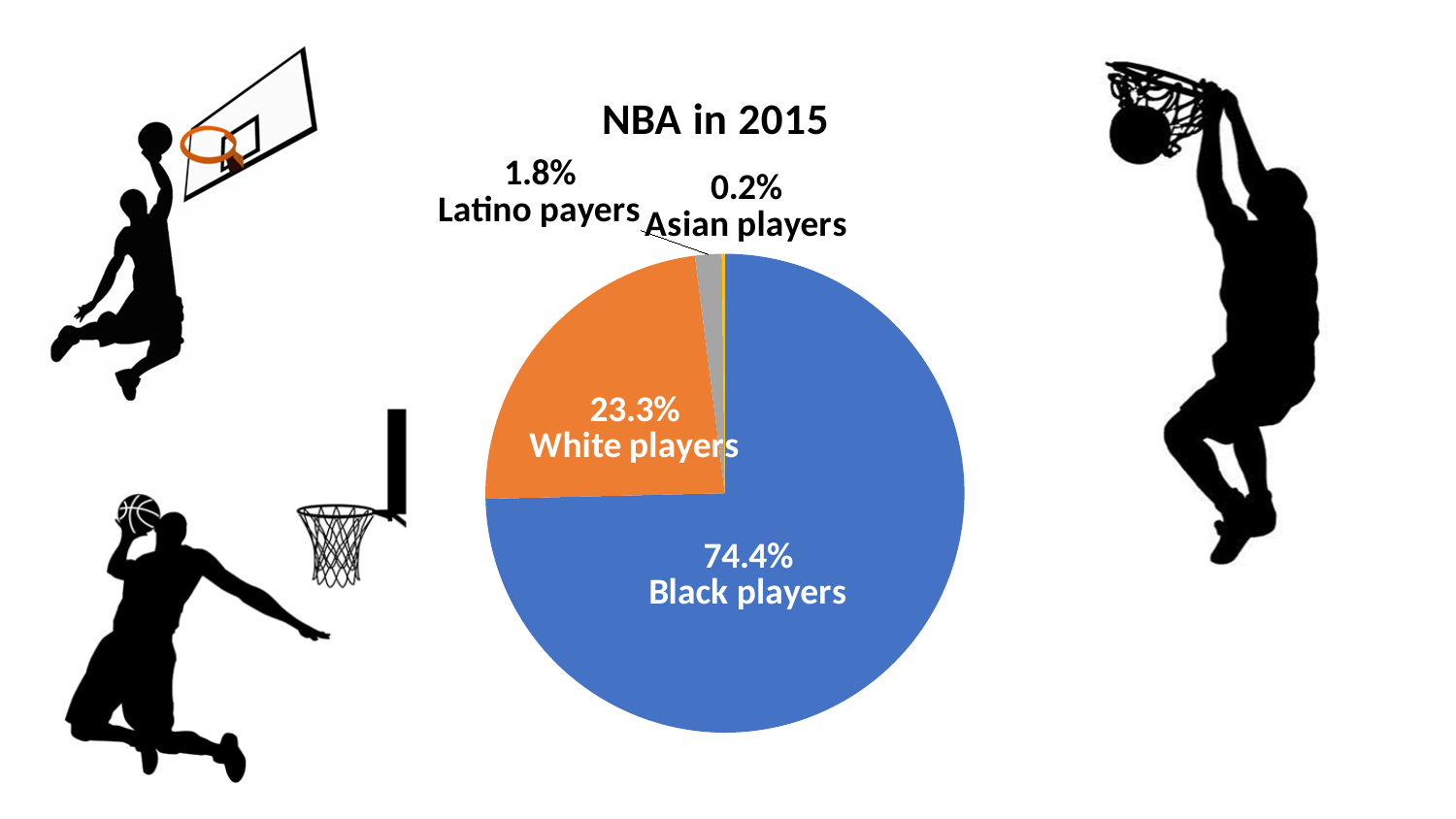
What percentage of the pie is labelled Black players? 74.4% What is the title of the chart? NBA in 2015 Which is larger, the share for Latino payers or the share for Asian players? Latino payers Which slice of the pie is the smallest? Asian players What type of chart is shown on the slide? Pie chart What colour is the slice for White players? Orange What is the difference between the Black players share and the White players share? 51.1% Which slice of the pie is the largest? Black players What percentage of the pie is labelled Latino payers? 1.8% How many slices does the pie chart have? 4 What percentage of the pie is labelled White players? 23.3% What percentage of the pie is labelled Asian players? 0.2%